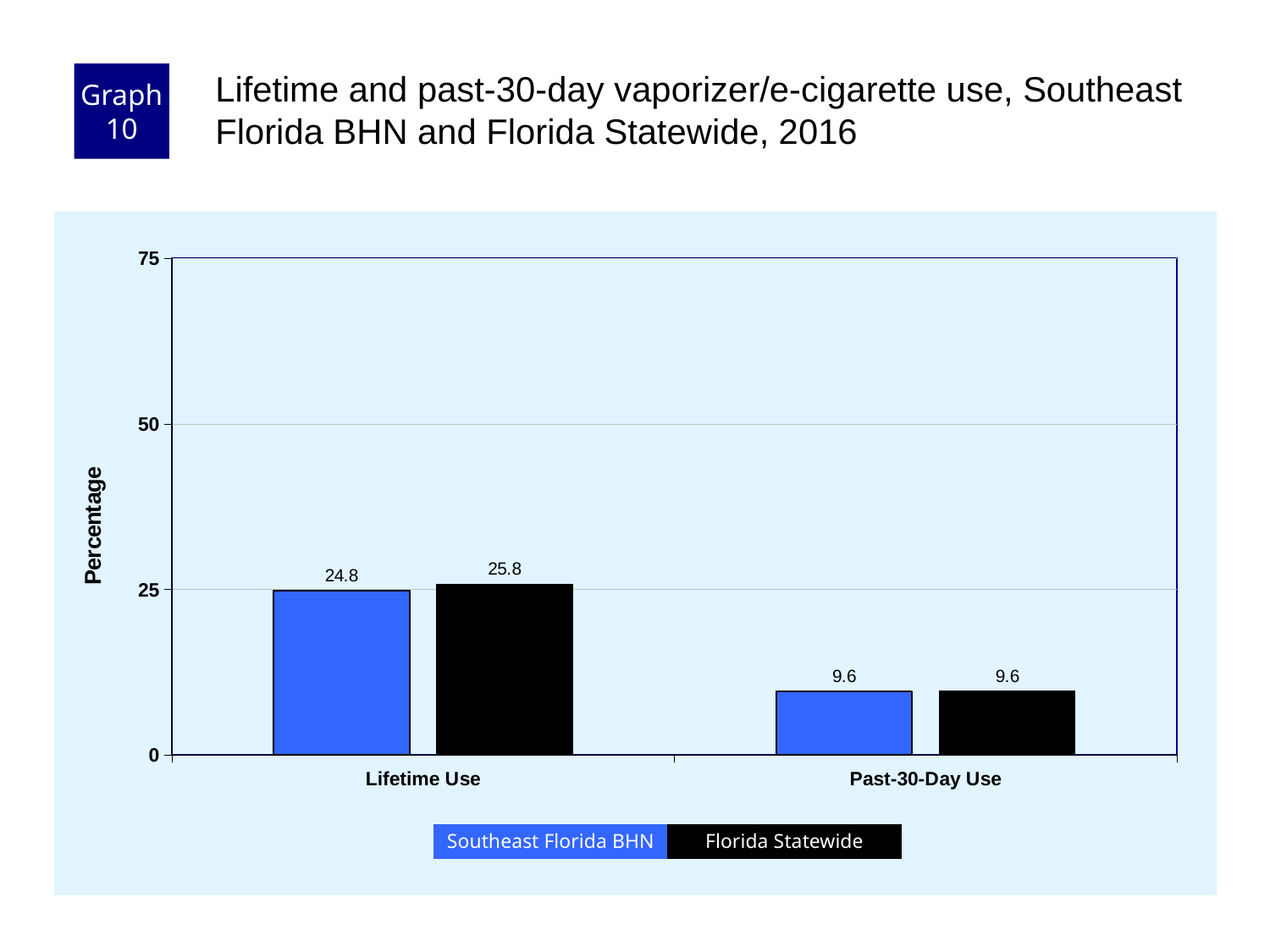
What is the Lifetime Use value for Southeast Florida BHN? 24.8 What is the Past-30-Day Use value for Florida Statewide? 9.6 How many categories are shown on the x axis? 2 What kind of chart is shown on the slide? bar chart What is the label of the y axis? Percentage For Lifetime Use, which series has the higher value, Southeast Florida BHN or Florida Statewide? Florida Statewide Which category has the lower values, Lifetime Use or Past-30-Day Use? Past-30-Day Use What is the Lifetime Use value for Florida Statewide? 25.8 Is the Lifetime Use value for Florida Statewide greater or less than 25? greater What is the Past-30-Day Use value for Southeast Florida BHN? 9.6 How many series does the legend list? 2 What is the difference between the Florida Statewide and Southeast Florida BHN values for Lifetime Use? 1.0